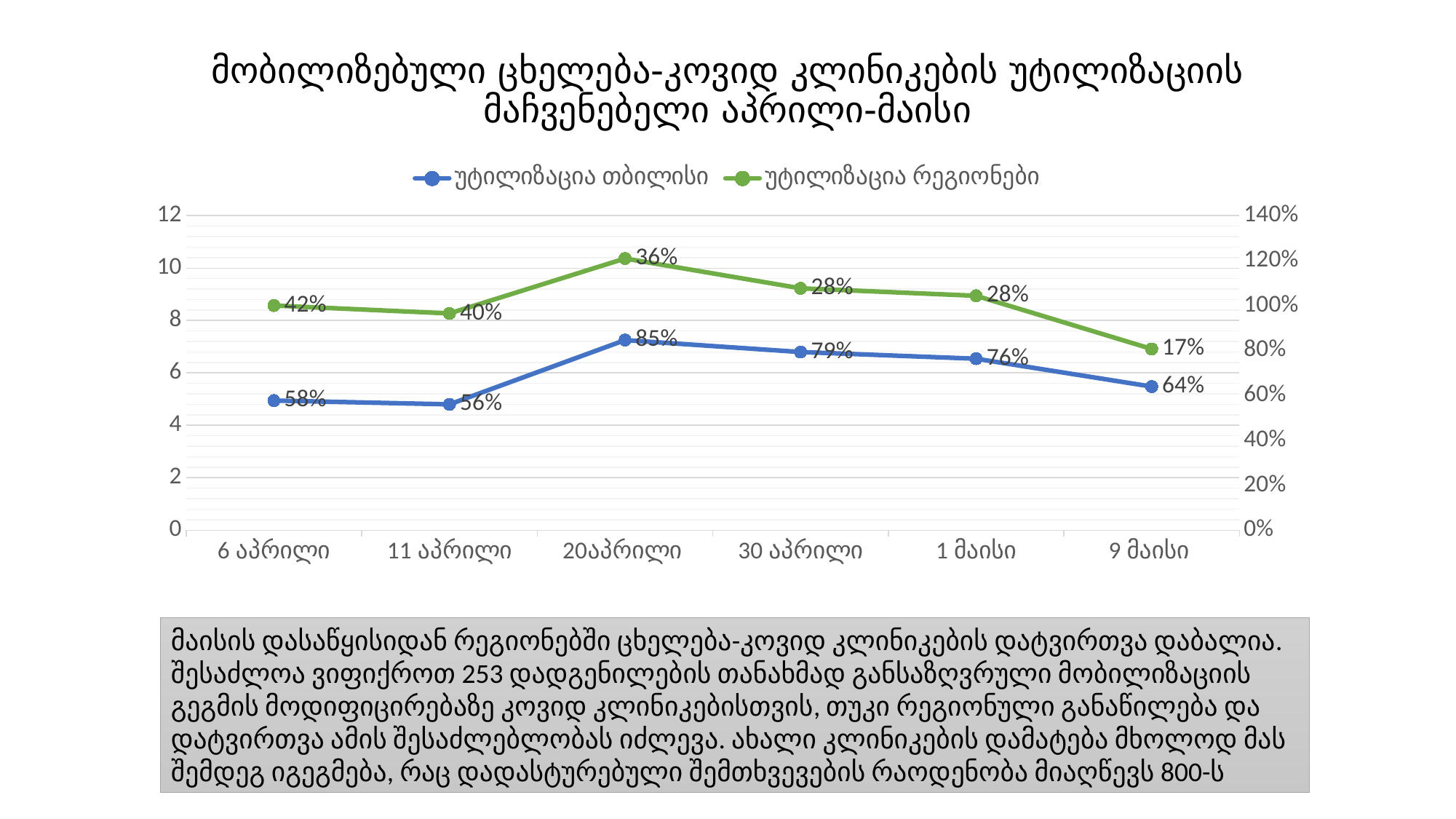
On which date is უტილიზაცია თბილისი highest? 20აპრილი On which date is უტილიზაცია რეგიონები lowest? 9 მაისი What is the value for უტილიზაცია თბილისი on 20აპრილი? 85% What is the value for უტილიზაცია რეგიონები on 30 აპრილი? 28% What is the value for უტილიზაცია რეგიონები on 9 მაისი? 17% What is the value for უტილიზაცია თბილისი on 6 აპრილი? 58% What type of chart is shown on the slide? line chart How many dates are shown on the x axis? 6 What is the difference between the უტილიზაცია თბილისი values on 20აპრილი and 9 მაისი? 21% How many series does the legend list? 2 Which colour is used for the უტილიზაცია რეგიონები line? green Does უტილიზაცია რეგიონები rise or fall from 20აპრილი to 9 მაისი? fall